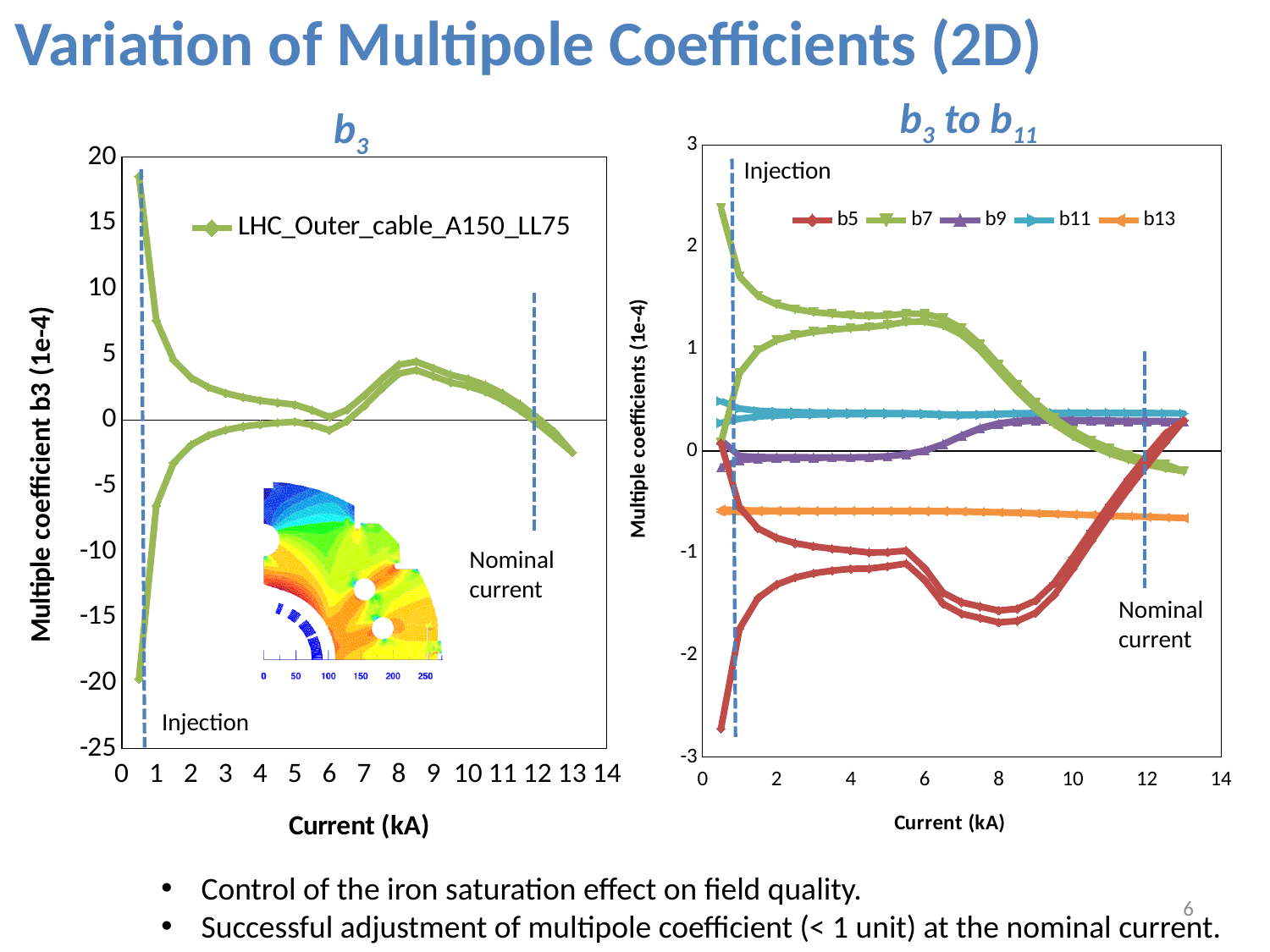
In the right chart (b3 to b11), is the value of b7 at 4 kA greater or less than 1? greater How many series does the legend of the right chart (b3 to b11) list? 5 In the right chart (b3 to b11), which is larger at 4 kA, b11 or b13? b11 In the left chart (b3), what is the name of the series shown in the legend? LHC_Outer_cable_A150_LL75 In the right chart (b3 to b11), which series has the lowest value at 8 kA? b5 What kind of chart is the left chart titled b3? line chart In the right chart (b3 to b11), which series has the highest value at 4 kA? b7 In the right chart (b3 to b11), is the value of b5 at 8 kA greater or less than -1? less In the right chart (b3 to b11), is the value of b13 at 6 kA greater or less than 0? less What is the x-axis title of the right chart (b3 to b11)? Current (kA)